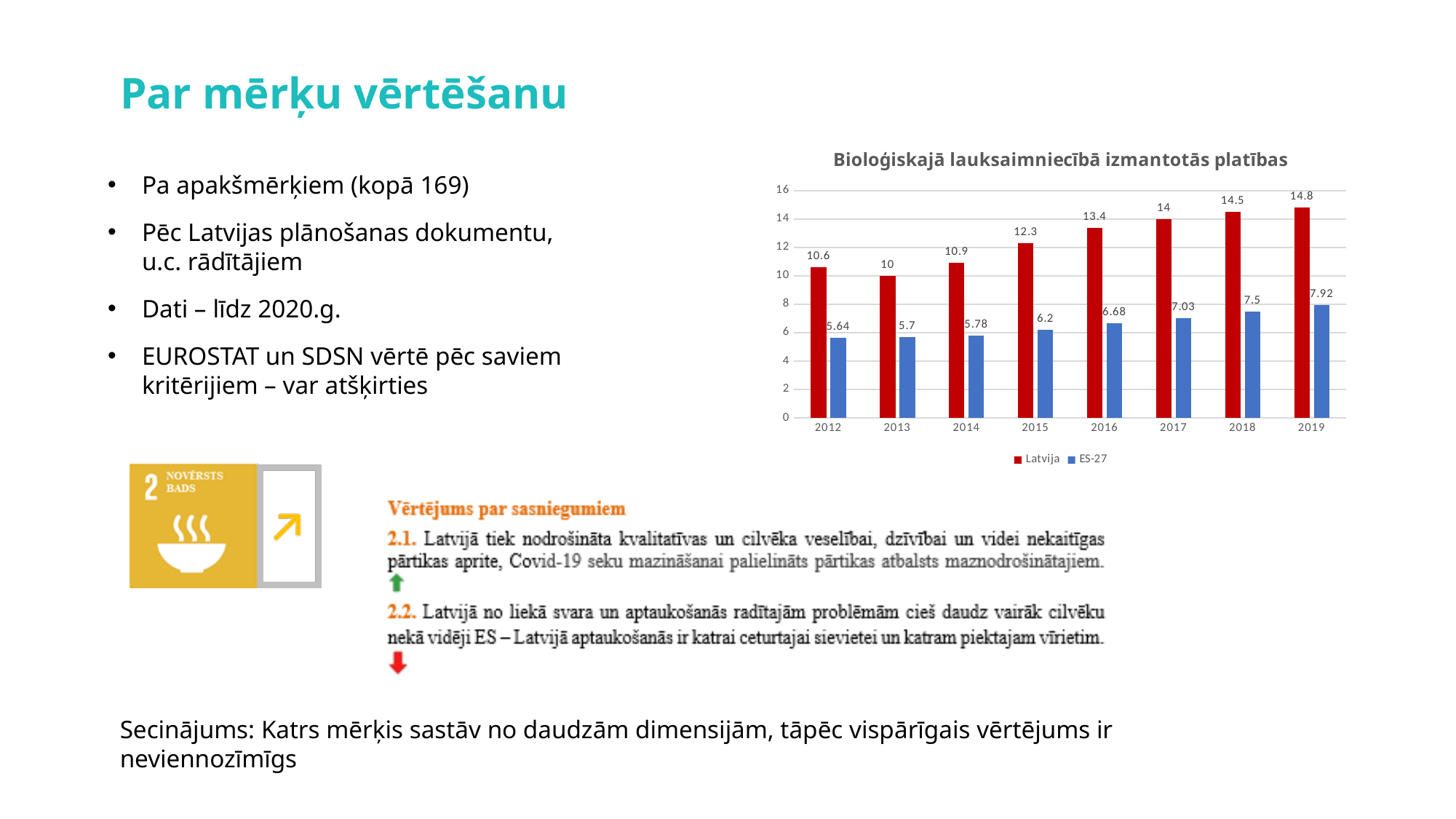
Is the value for ES-27 in 2014 greater or less than 6? less How many years are shown on the x axis? 8 In which year is the ES-27 value highest? 2019 How many series does the legend list? 2 What is the value for Latvija in 2019? 14.8 What is the difference between the Latvija and ES-27 values in 2012? 4.96 What is the value for Latvija in 2015? 12.3 Do the ES-27 values rise or fall from 2012 to 2019? rise What kind of chart is shown? bar chart Which is larger in 2018, the Latvija value or the ES-27 value? Latvija What is the value for ES-27 in 2017? 7.03 In which year is the Latvija value lowest? 2013